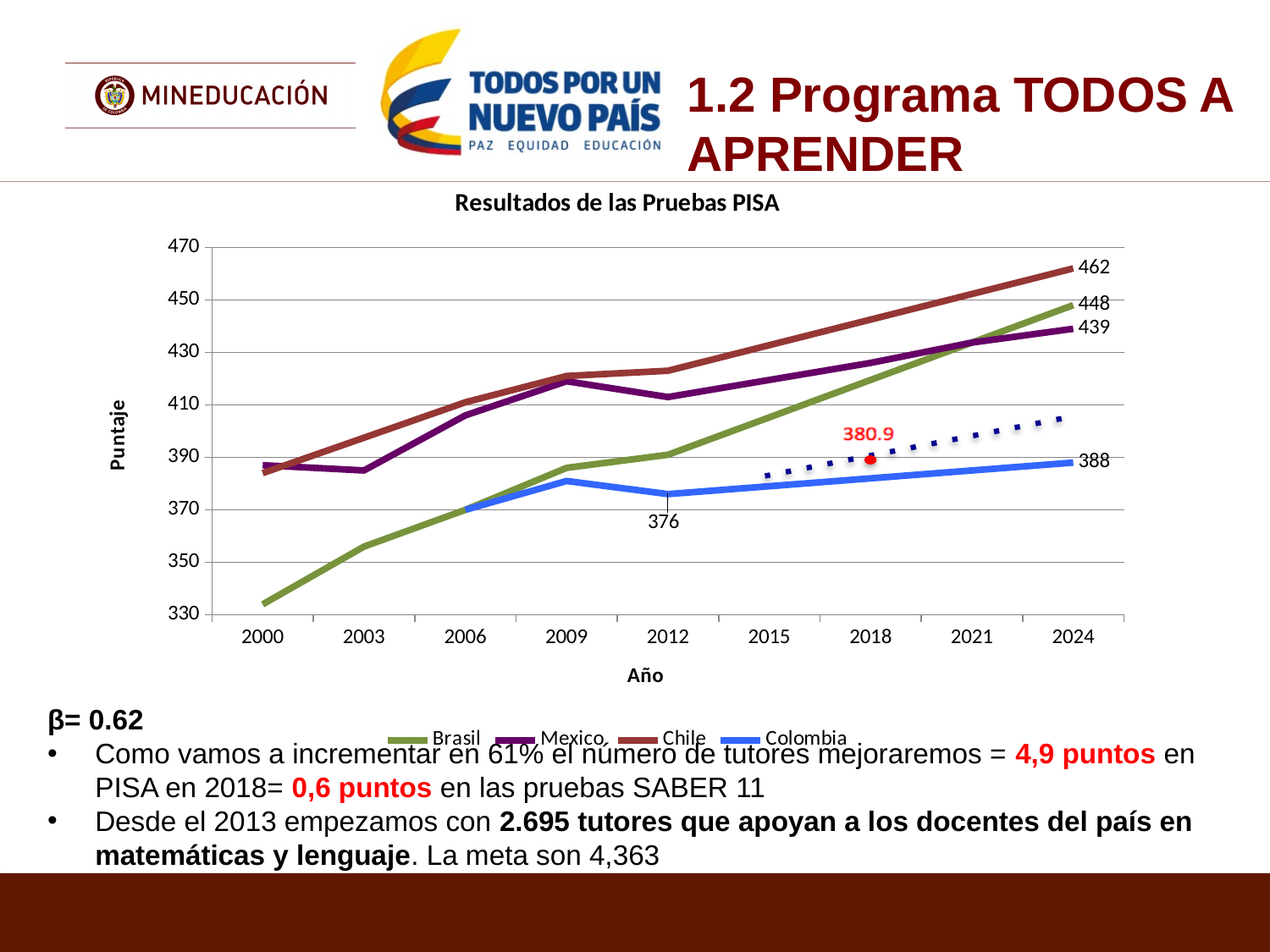
Is the value for Chile in 2009 greater or less than 410? greater What is the title of the chart? Resultados de las Pruebas PISA How many series does the legend list? 4 Is the value for Brasil in 2000 greater or less than 350? less What kind of chart is shown? line chart What is the value for Colombia in 2012? 376 Which is larger in 2024, Brasil or Mexico? Brasil What is the value for Brasil in 2024? 448 Which country has the highest value in 2024? Chile Which country has the lowest value in 2024? Colombia What is the difference between Chile and Brasil in 2024? 14 What is the value for Chile in 2024? 462